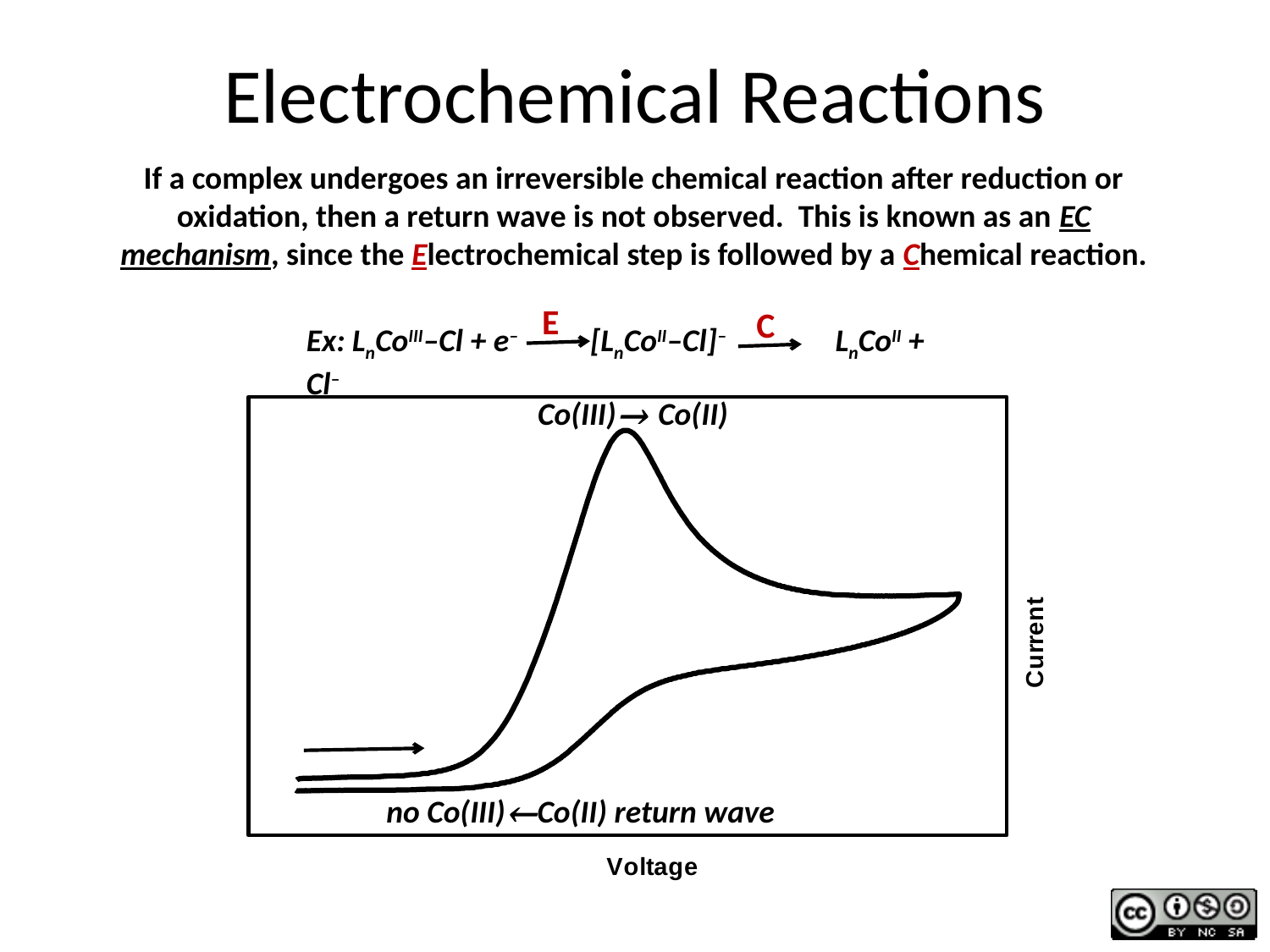
Which process is labelled at the peak of the curve? Co(III) → Co(II) After the labelled peak, does the current rise or fall as voltage continues to increase? fall What kind of chart is shown on the slide? line chart Does the chart show a Co(III) ← Co(II) return wave? No How many peaks does the curve in the chart show? 1 What is the label on the horizontal axis of the chart? Voltage What is the label on the vertical axis of the chart? Current How many curves (traces) are plotted in the chart? 1 Along the forward scan, does the current rise or fall as it approaches the labelled peak? rise